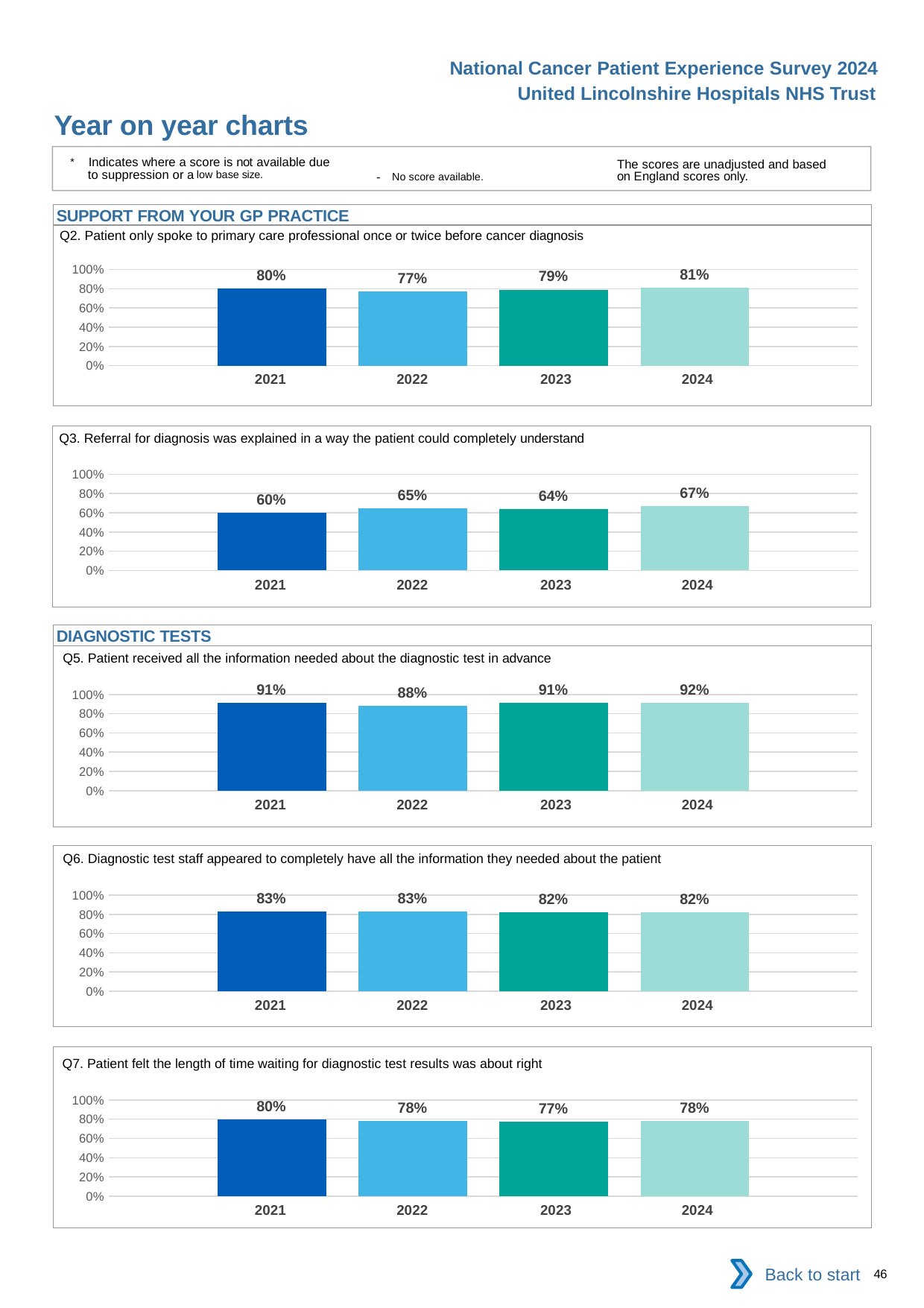
In the Q7 chart, what is the difference between the 2021 value and the 2023 value? 3% In the Q2 chart (Patient only spoke to primary care professional once or twice before cancer diagnosis), what is the value for 2024? 81% In the Q3 chart (Referral for diagnosis was explained in a way the patient could completely understand), what is the value for 2021? 60% How many years are shown on the x axis of the Q7 chart? 4 In the Q6 chart (Diagnostic test staff appeared to completely have all the information they needed about the patient), what is the value for 2023? 82% In the Q2 chart, which year has the lowest value? 2022 In the Q7 chart (Patient felt the length of time waiting for diagnostic test results was about right), what is the value for 2021? 80% In the Q5 chart (Patient received all the information needed about the diagnostic test in advance), what is the value for 2022? 88% In the Q3 chart, what is the difference between the 2024 value and the 2021 value? 7% In the Q6 chart, is the value for 2021 greater or less than 80%? greater In the Q5 chart, which is larger, the value for 2022 or the value for 2024? 2024 In the Q3 chart, which year has the highest value? 2024